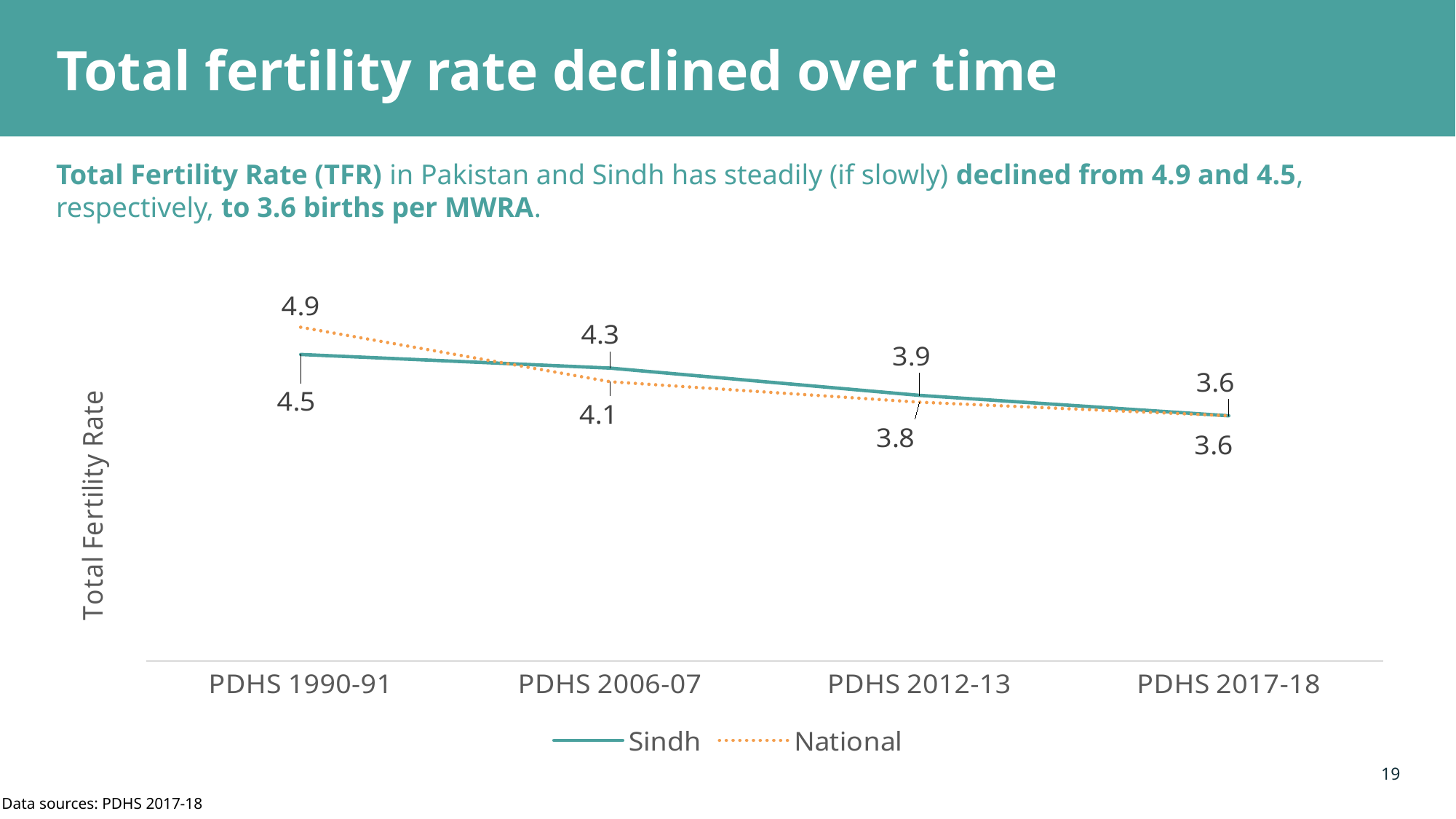
What is the National value for PDHS 2012-13? 3.8 How many series does the legend list? 2 What is the Sindh total fertility rate for PDHS 1990-91? 4.5 Which series has the larger value for PDHS 2006-07, Sindh or National? Sindh What is the difference between the National and Sindh values for PDHS 1990-91? 0.4 In which survey is the National total fertility rate highest? PDHS 1990-91 What is the National total fertility rate for PDHS 1990-91? 4.9 Do the Sindh values rise or fall from PDHS 1990-91 to PDHS 2017-18? fall How many surveys are shown on the x axis? 4 In which survey is the Sindh total fertility rate lowest? PDHS 2017-18 What is the Sindh value for PDHS 2017-18? 3.6 What is the Sindh value for PDHS 2006-07? 4.3